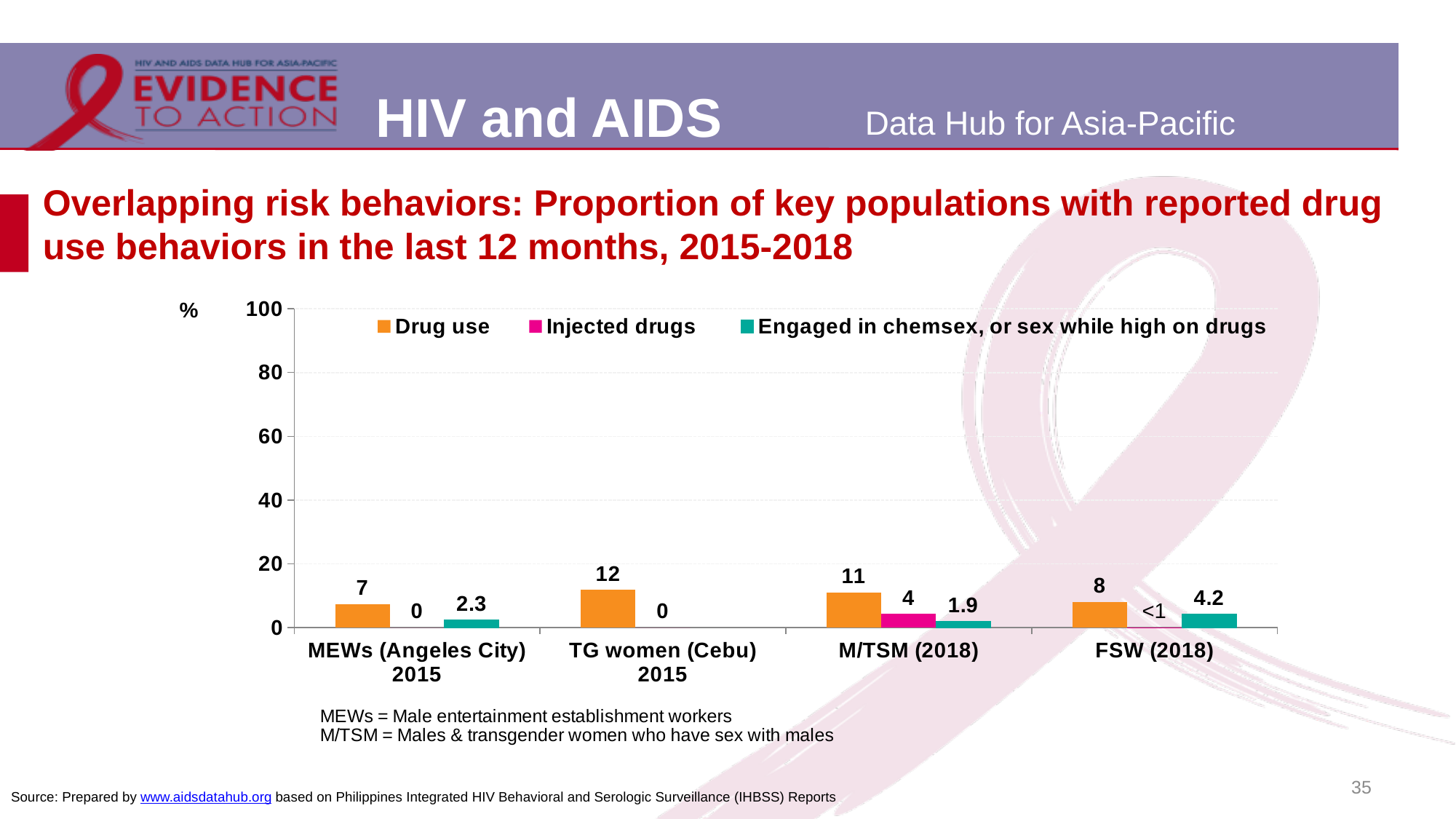
What kind of chart is shown on the slide? Bar chart Which category has the lowest Drug use value? MEWs (Angeles City) 2015 What is the Injected drugs value for M/TSM (2018)? 4 How many series does the legend list? 3 What is the difference between the Drug use values for TG women (Cebu) 2015 and MEWs (Angeles City) 2015? 5 What is the Drug use value for TG women (Cebu) 2015? 12 What is the Injected drugs value shown for FSW (2018)? <1 Which is larger: the chemsex value for FSW (2018) or for M/TSM (2018)? FSW (2018) What is the value for Engaged in chemsex, or sex while high on drugs for FSW (2018)? 4.2 How many key population categories are shown on the x axis? 4 Which category has the highest Drug use value? TG women (Cebu) 2015 Is the Drug use value for M/TSM (2018) greater or less than 20? less